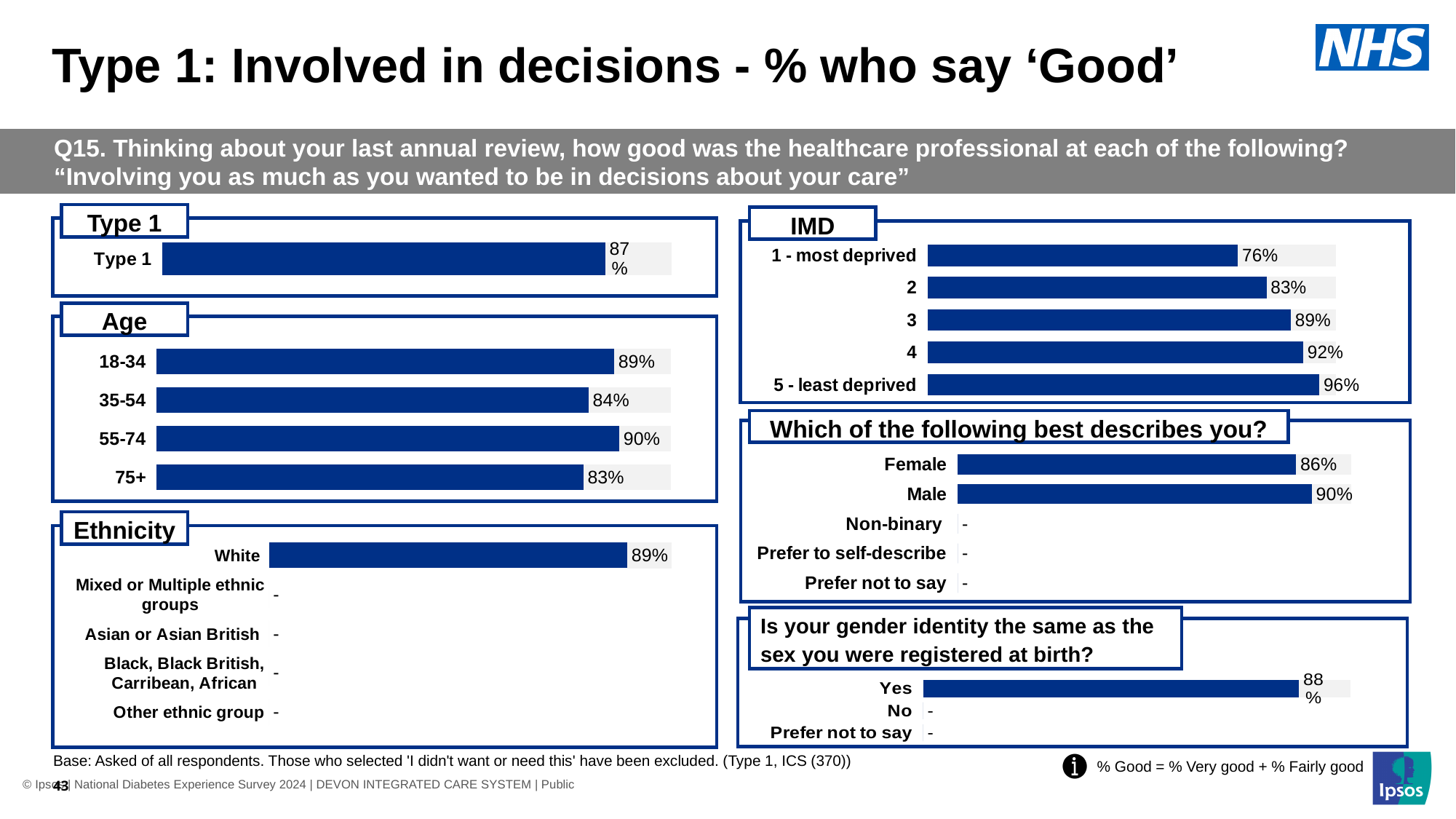
In the Age chart, what is the value for the 35-54 age group? 84% In the 'Is your gender identity the same as the sex you were registered at birth?' chart, what is the value for Yes? 88% In the Type 1 chart, what percentage of Type 1 respondents say 'Good'? 87% In the IMD chart, which category has the lowest value? 1 - most deprived In the IMD chart, what is the value for '5 - least deprived'? 96% In the Age chart, which age group has the lowest value? 75+ In the Ethnicity chart, what is the value for White? 89% In the Age chart, what is the difference between the 18-34 and 75+ values? 6 percentage points In the Age chart, which age group has the highest value? 55-74 In the IMD chart, what is the difference between the values for '5 - least deprived' and '1 - most deprived'? 20 percentage points In the IMD chart, do the values rise or fall from '1 - most deprived' to '5 - least deprived'? rise In the 'Which of the following best describes you?' chart, which is larger, Female or Male? Male